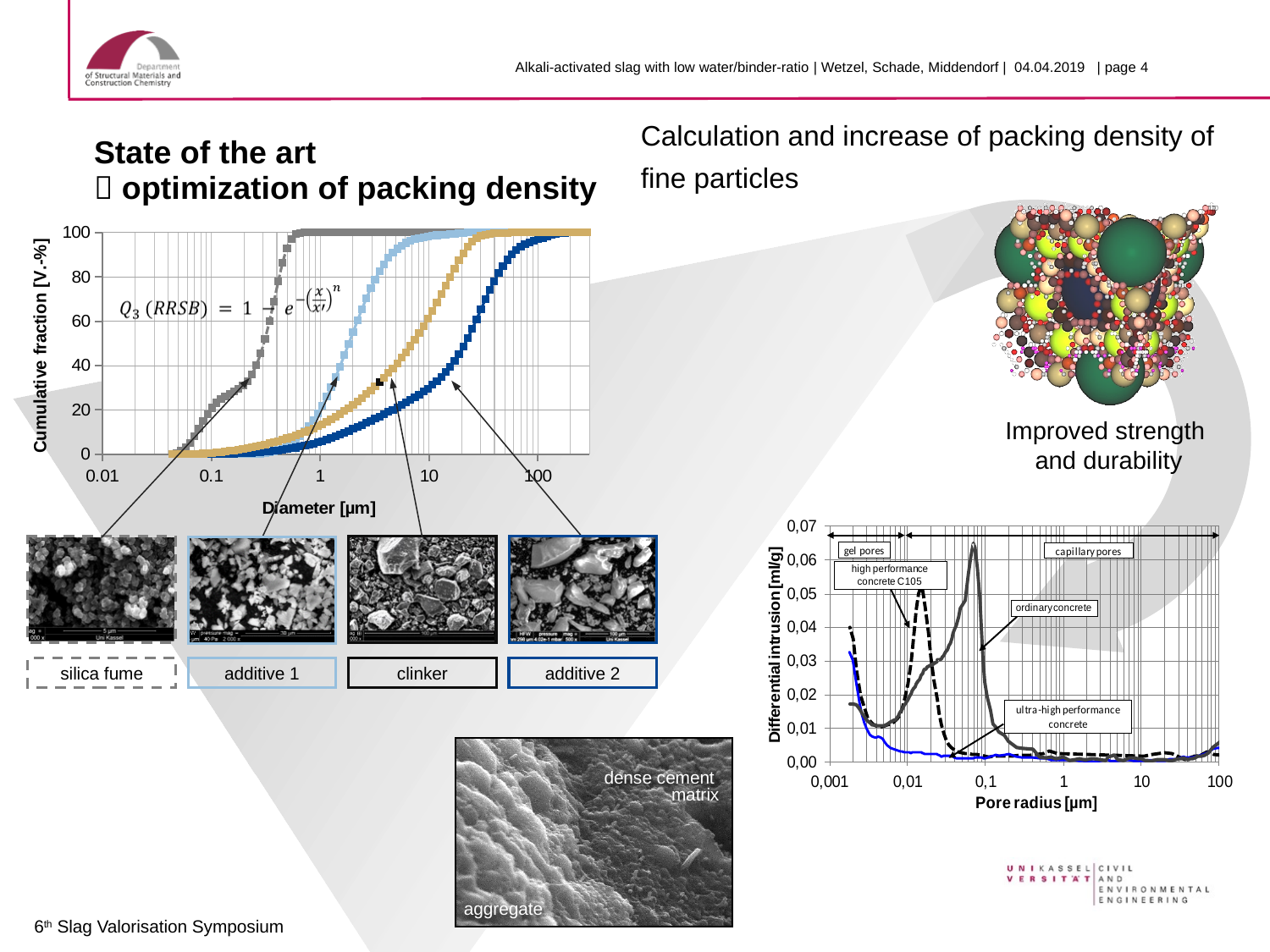
In the cumulative fraction chart on the left, how many material curves are plotted? 4 What kind of chart is the cumulative fraction chart on the left of the slide? line chart In the cumulative fraction chart on the left, at a diameter of 10 µm, is the cumulative fraction of additive 2 greater or less than 60? less In the cumulative fraction chart on the left, does the cumulative fraction rise or fall as the diameter increases? rise What is the y-axis label of the pore radius chart on the right? Differential intrusion [ml/g] In the cumulative fraction chart on the left, at a diameter of 1 µm, is the cumulative fraction of silica fume greater or less than 80? greater In the pore radius chart on the right, which concrete type has the highest peak of differential intrusion? ordinary concrete In the cumulative fraction chart on the left, which material reaches 100 V.-% at the smallest diameter? silica fume In the pore radius chart on the right, is the peak differential intrusion of high performance concrete C105 greater or less than 0,06 ml/g? less In the cumulative fraction chart on the left, which material reaches 100 V.-% at the largest diameter? additive 2 What is the x-axis label of the cumulative fraction chart on the left? Diameter [µm] In the pore radius chart on the right, how many concrete types are labelled? 3